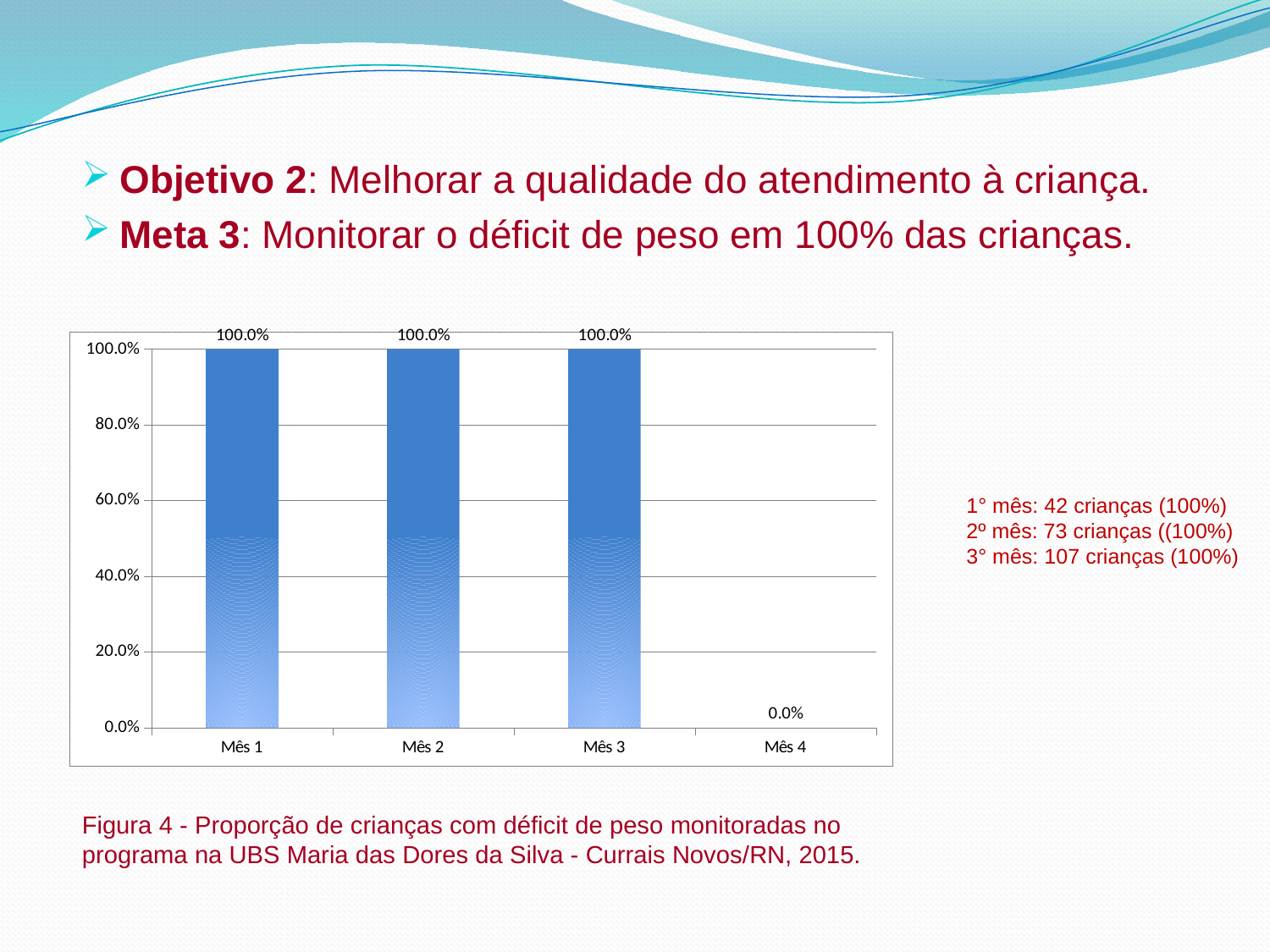
How many categories are shown on the x axis? 4 Which is larger, the value for Mês 3 or the value for Mês 4? Mês 3 What is the highest value shown on the y axis? 100.0% What is the value for Mês 4? 0.0% What is the difference between the values for Mês 2 and Mês 4? 100.0% Do the values rise, fall or stay the same from Mês 1 to Mês 3? stay the same What is the value for Mês 1? 100.0% Is the value for Mês 2 greater or less than 80.0%? greater What is the value for Mês 3? 100.0% What kind of chart is shown? bar chart Which category has the lowest value? Mês 4 What is the figure number given in the caption below the chart? Figura 4